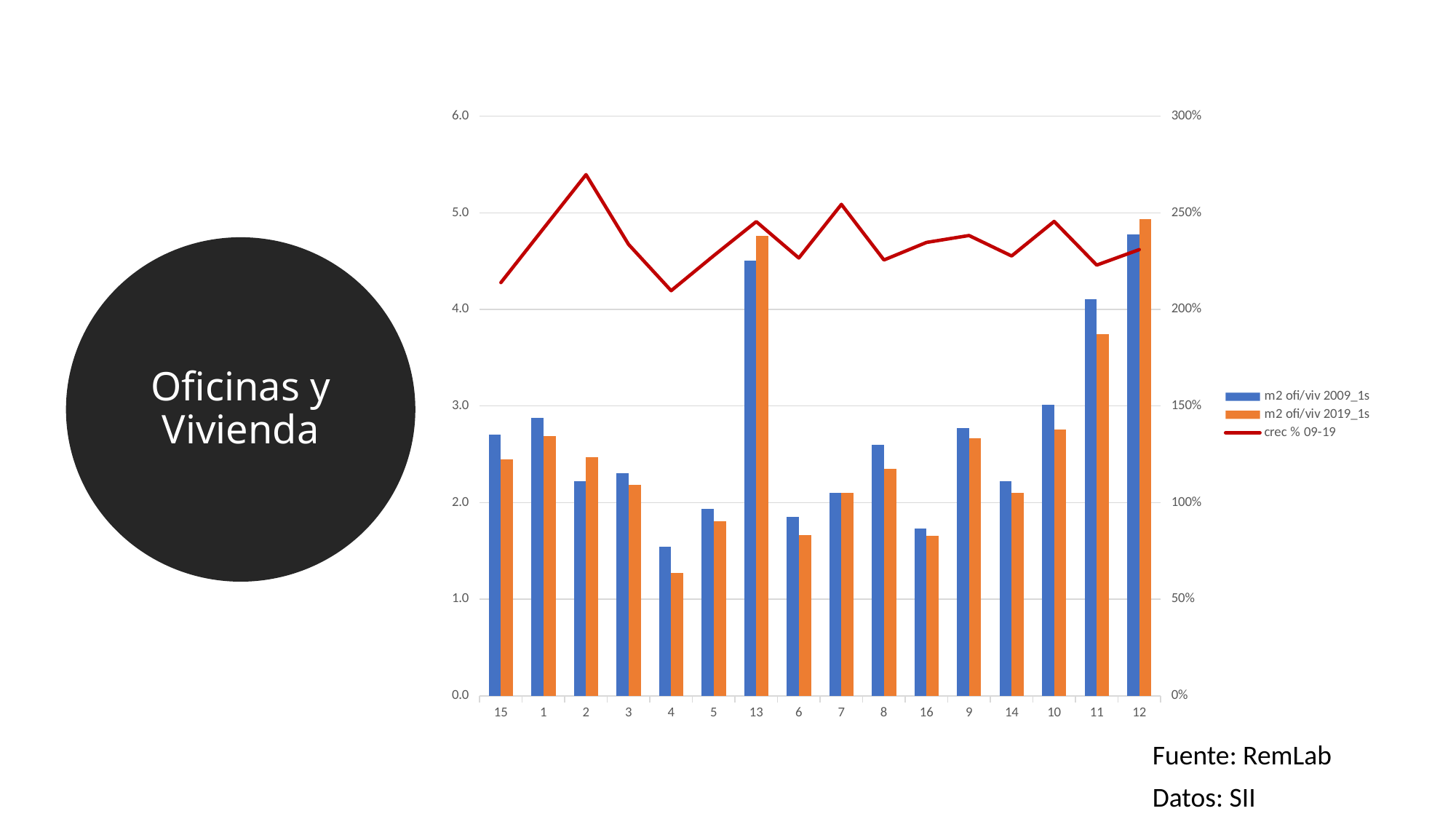
Which category has the lowest value on the crec % 09-19 line? 4 Is the crec % 09-19 value at category 2 greater or less than 250%? greater Which category has the highest value for m2 ofi/viv 2019_1s? 12 Is the value for m2 ofi/viv 2009_1s at category 13 greater or less than 4.0? greater What kind of chart is shown on the slide? A combined bar and line chart Which category has the highest value on the crec % 09-19 line? 2 Which category has the lowest value for m2 ofi/viv 2009_1s? 4 How many series does the legend list? 3 Is the value for m2 ofi/viv 2019_1s at category 11 greater or less than 3.0? greater How many categories are shown on the x axis? 16 Which series is drawn as a red line? crec % 09-19 At category 11, which is larger: m2 ofi/viv 2009_1s or m2 ofi/viv 2019_1s? m2 ofi/viv 2009_1s